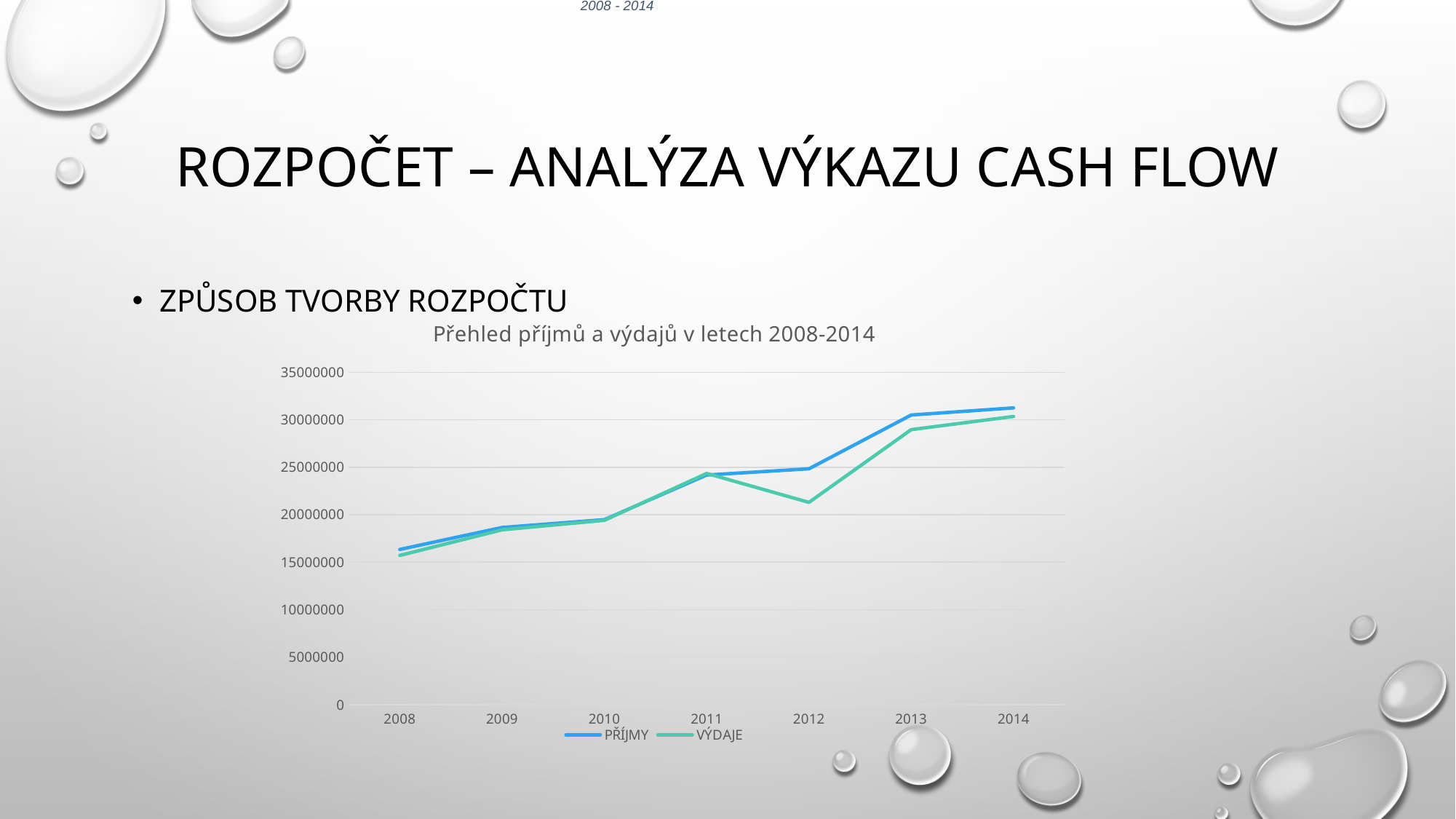
Which series is drawn in green in the chart? VÝDAJE How many series does the legend of the chart list? 2 How many years are plotted along the x axis of the chart? 7 Is the VÝDAJE value for 2012 greater or less than 25000000? less In which year is the VÝDAJE value highest? 2014 In 2012, which series has the larger value, PŘÍJMY or VÝDAJE? PŘÍJMY In which year is the VÝDAJE value lowest? 2008 Is the PŘÍJMY value for 2013 greater or less than 30000000? greater What kind of chart is shown on the slide? line chart What is the title of the chart? Přehled příjmů a výdajů v letech 2008-2014 Does the PŘÍJMY line rise or fall from 2008 to 2014? rise Is the VÝDAJE value for 2008 greater or less than 15000000? greater